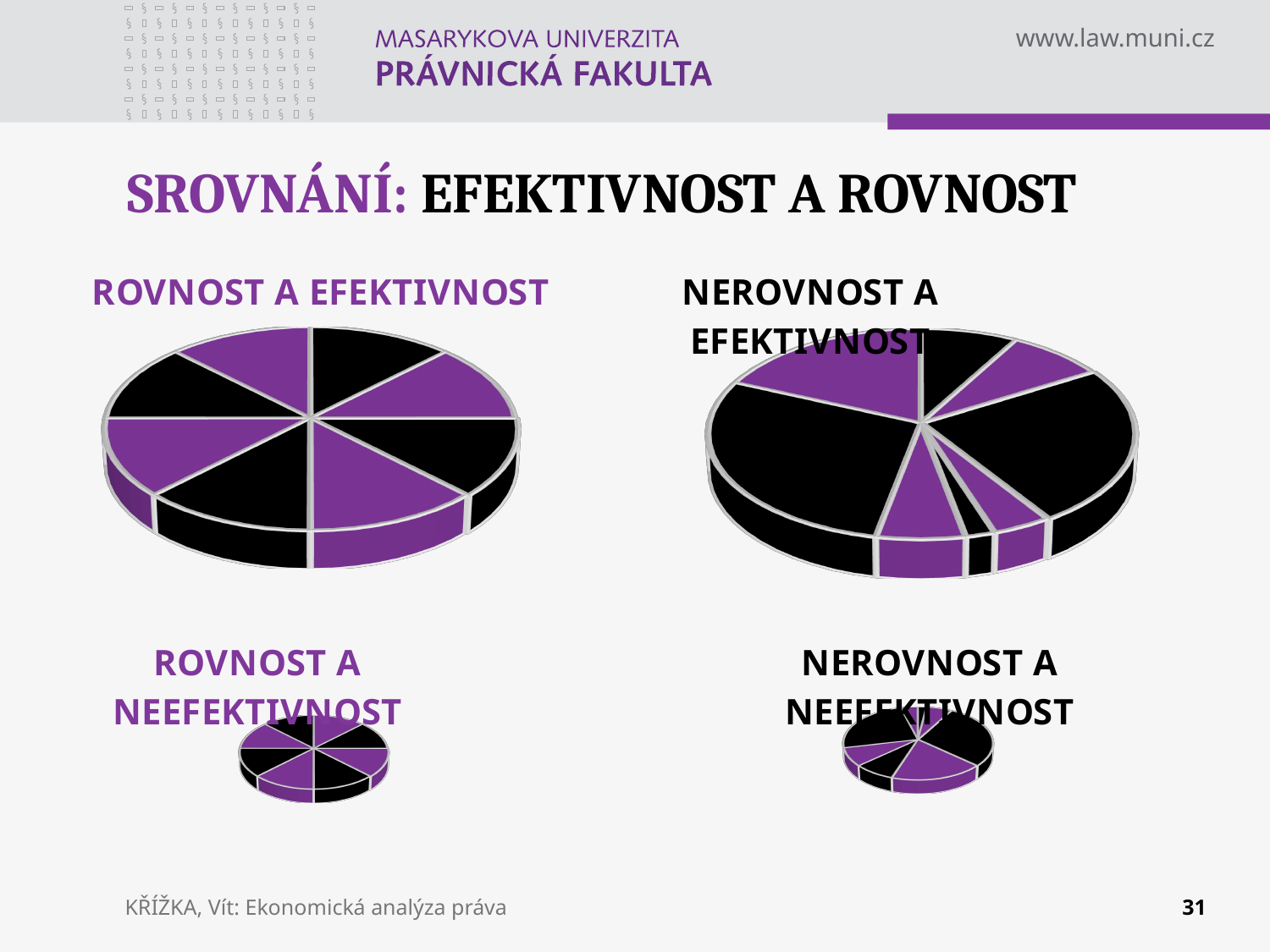
Are the slices in the pie chart titled "ROVNOST A EFEKTIVNOST" all roughly the same size? yes In the pie chart titled "NEROVNOST A EFEKTIVNOST", what colour is the largest slice? black What kind of chart is the chart titled "ROVNOST A EFEKTIVNOST"? pie chart What is the title of the pie chart in the top-left of the slide? ROVNOST A EFEKTIVNOST How many slices does the pie chart titled "ROVNOST A EFEKTIVNOST" have? 8 What kind of chart is the chart titled "NEROVNOST A EFEKTIVNOST"? pie chart Which pie chart is drawn larger on the slide, "ROVNOST A EFEKTIVNOST" or "ROVNOST A NEEFEKTIVNOST"? ROVNOST A EFEKTIVNOST How many pie charts are shown on the slide? 4 Are the slices in the pie chart titled "NEROVNOST A EFEKTIVNOST" all the same size? no